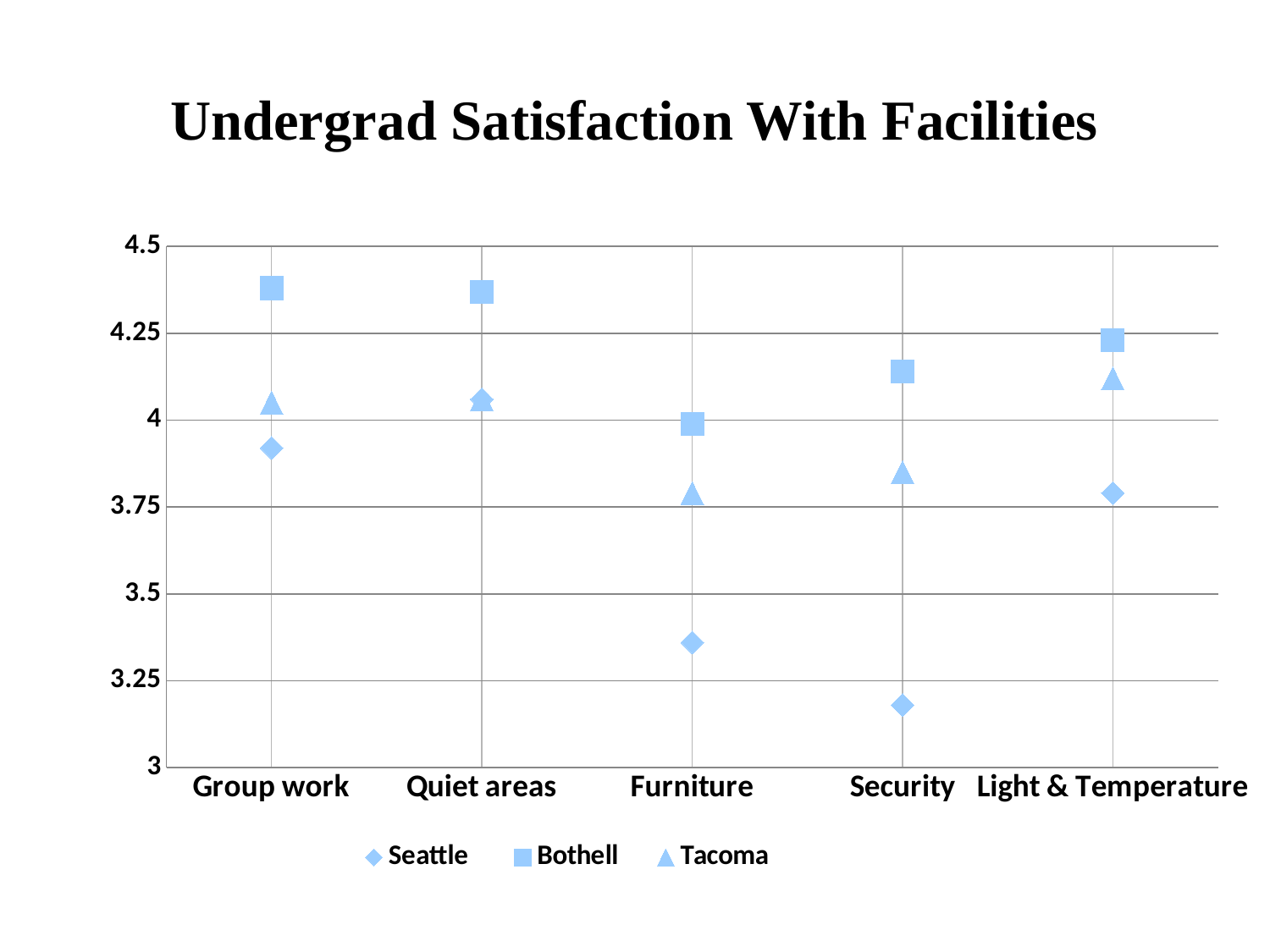
Is the Seattle value for Furniture greater or less than 3.5? less Which series has the highest value for Security? Bothell Is the Seattle value for Security greater or less than 3.25? less Which series is plotted with square markers? Bothell For which category is the Seattle value lowest? Security Is the Bothell value for Group work greater or less than 4.25? greater How many series does the legend list? 3 How many facility categories are shown on the x axis? 5 What is the title of the chart? Undergrad Satisfaction With Facilities Which series has the lowest value for Furniture? Seattle